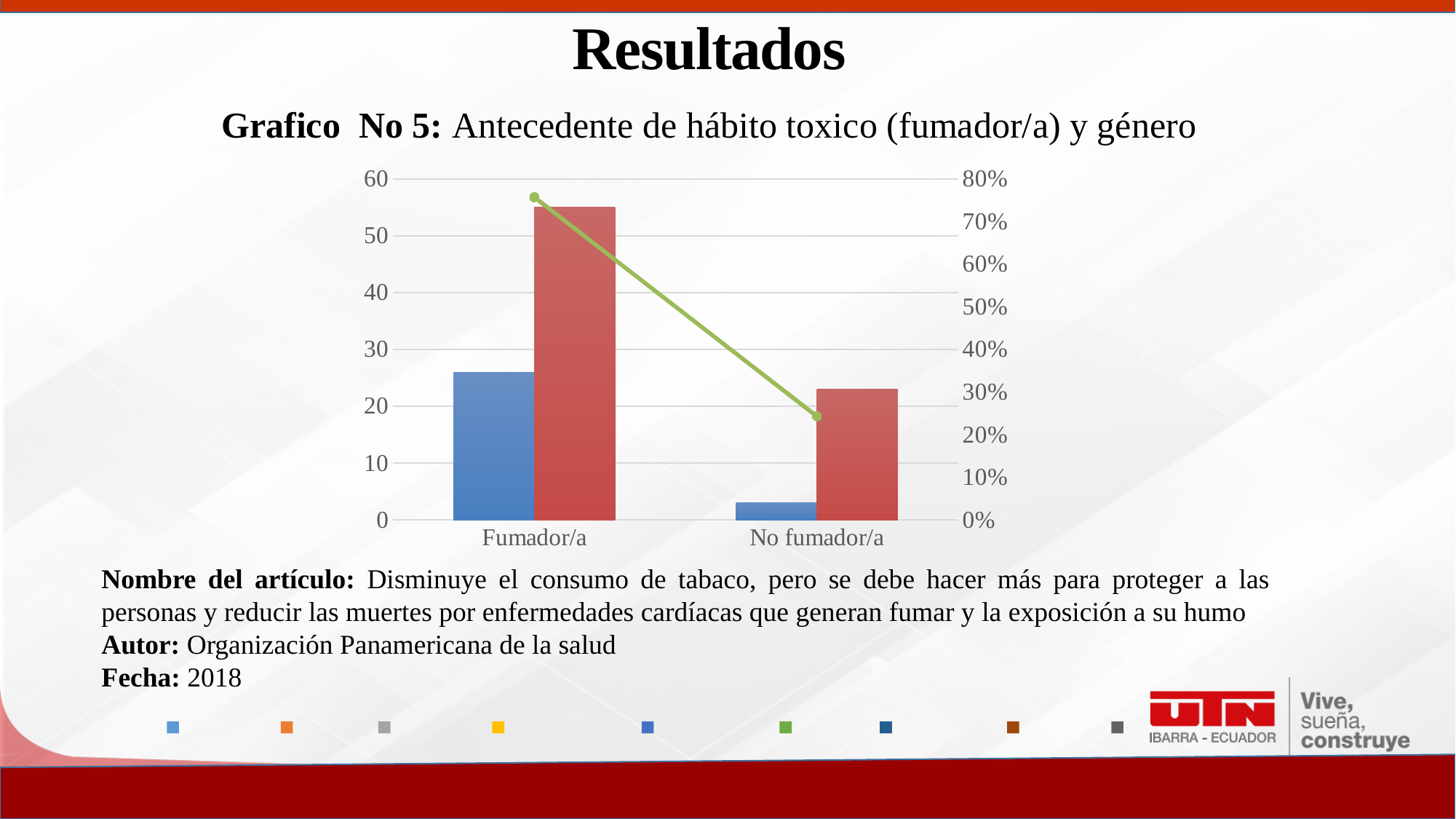
Is the value of the red bar for No fumador/a greater or less than 30? less Is the green line value for No fumador/a greater or less than 30%? less What is the title of the chart (Grafico No 5)? Antecedente de hábito toxico (fumador/a) y género Does the green line rise or fall from Fumador/a to No fumador/a? fall What kind of chart is shown on the slide? bar chart with a line Is the green line value for Fumador/a greater or less than 70%? greater Which category has the taller blue bar, Fumador/a or No fumador/a? Fumador/a Which category has the taller red bar, Fumador/a or No fumador/a? Fumador/a How many categories are shown on the x axis of the chart? 2